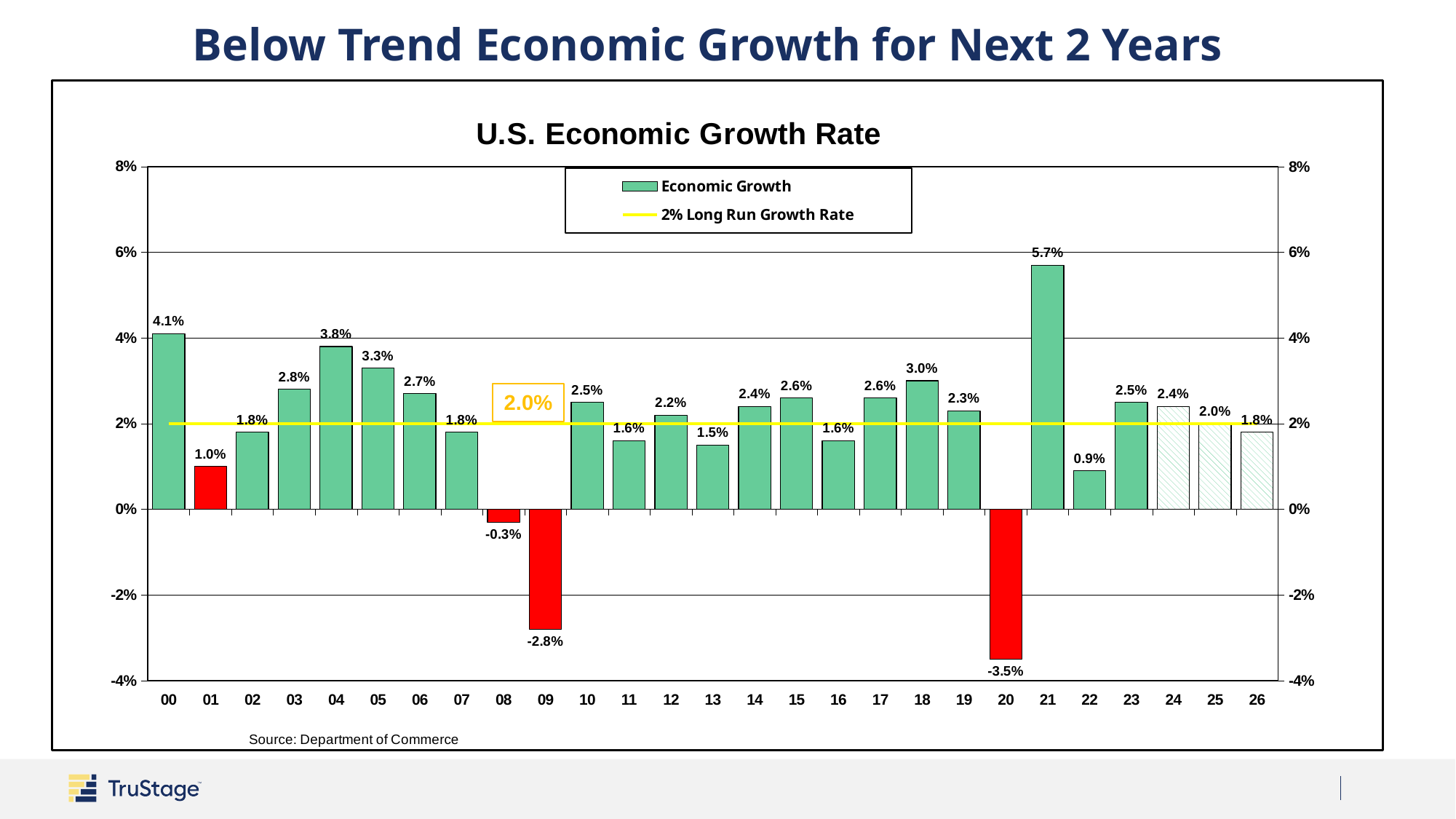
How many entries does the chart legend list? 2 How many years are shown on the x axis of the chart? 27 Which year has the lowest economic growth rate on the chart? 20 What is the economic growth rate shown for 2021 (labelled 21)? 5.7% What is the economic growth rate shown for 2009 (labelled 09)? -2.8% What is the difference between the growth rate in 2000 (00) and in 2001 (01)? 3.1% What is the projected economic growth rate for 2026 (labelled 26)? 1.8% What type of chart is used to show the U.S. Economic Growth Rate? Bar chart Which year has the highest economic growth rate on the chart? 21 What is the title of the chart on the slide? U.S. Economic Growth Rate Which year has a higher growth rate, 2004 (04) or 2018 (18)? 04 Is the growth rate for 2022 (22) greater or less than 2%? less